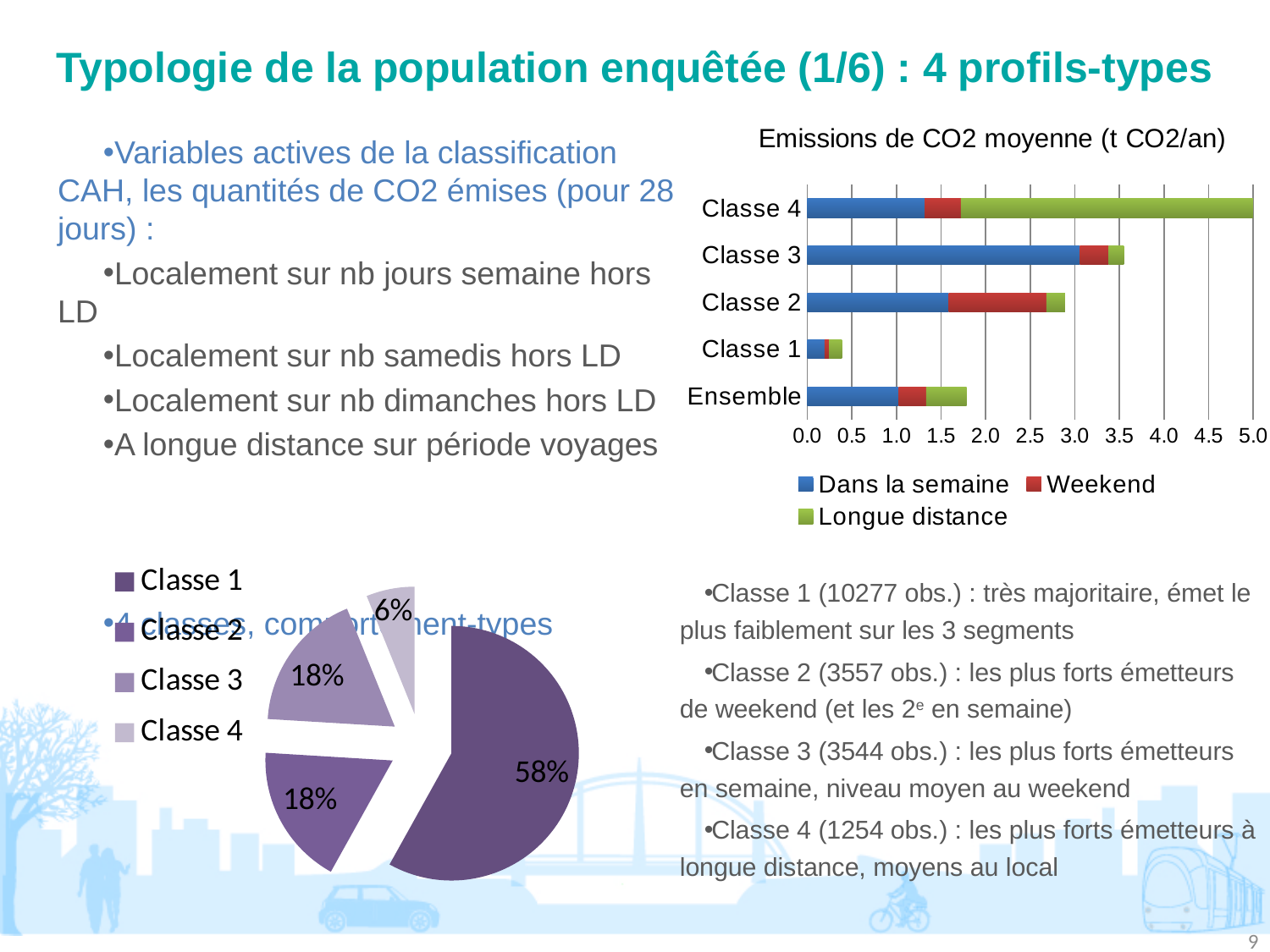
In the chart 'Emissions de CO2 moyenne (t CO2/an)', which category has the largest 'Longue distance' segment? Classe 4 What kind of chart is the chart titled 'Emissions de CO2 moyenne (t CO2/an)'? bar chart In the chart 'Emissions de CO2 moyenne (t CO2/an)', which has the larger total bar, Classe 2 or Classe 3? Classe 3 In the chart 'Emissions de CO2 moyenne (t CO2/an)', is the total value for Classe 3 greater or less than 3.0? greater In the chart 'Emissions de CO2 moyenne (t CO2/an)', which category has the shortest total bar? Classe 1 In the pie chart at the bottom left, how many slices are there? 4 In the chart 'Emissions de CO2 moyenne (t CO2/an)', how many series does the legend list? 3 In the chart 'Emissions de CO2 moyenne (t CO2/an)', is the total value for Ensemble greater or less than 2.0? less In the pie chart at the bottom left, what share does Classe 1 have? 58% In the chart 'Emissions de CO2 moyenne (t CO2/an)', which category has the longest total bar? Classe 4 In the pie chart at the bottom left, which class has the smallest slice? Classe 4 In the chart 'Emissions de CO2 moyenne (t CO2/an)', how many categories are shown on the vertical axis? 5